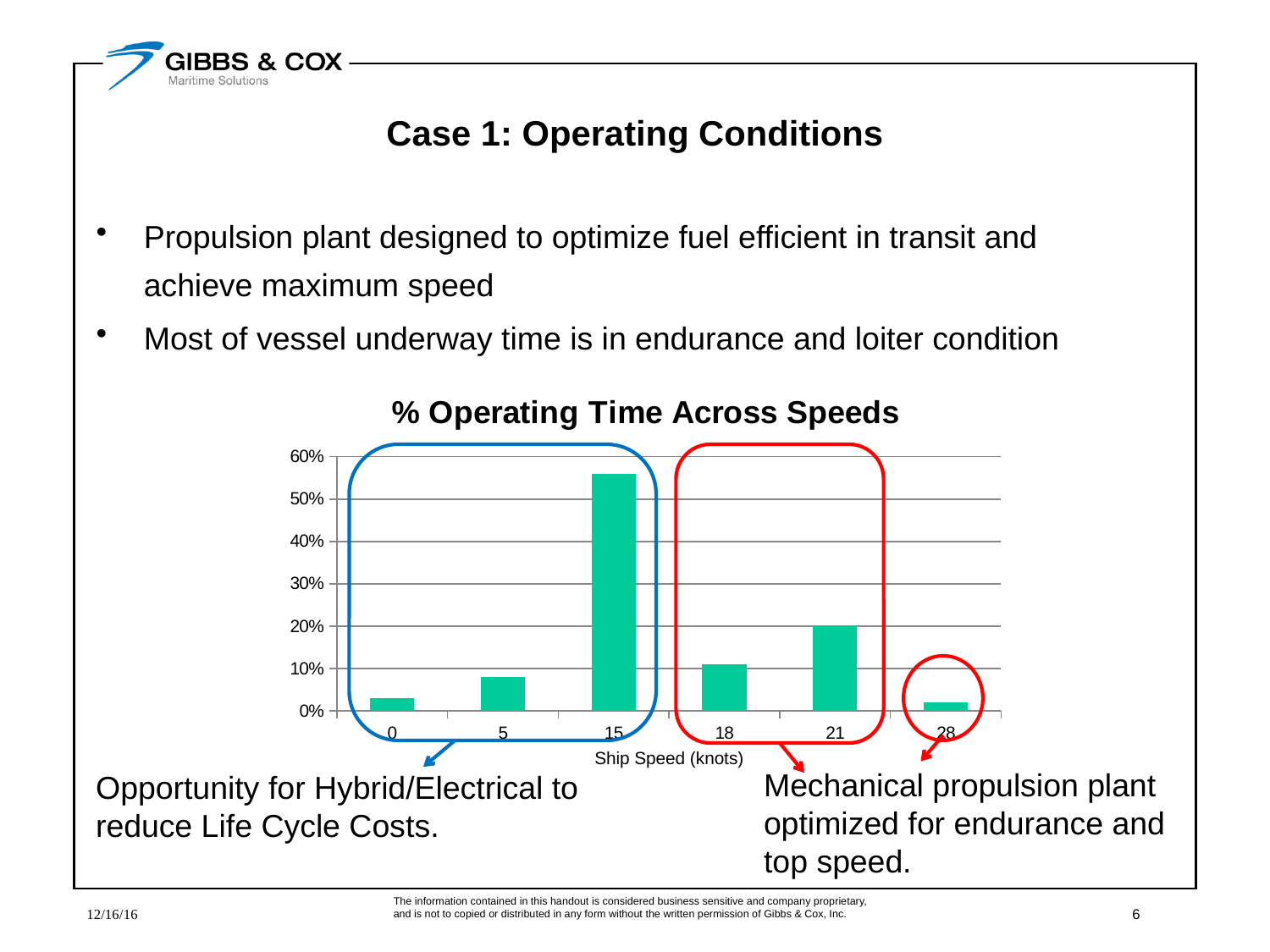
Which has a larger percentage of operating time, a ship speed of 5 knots or 0 knots? 5 Which ship speed has the lowest percentage of operating time? 28 Is the value for a ship speed of 18 knots greater or less than 20%? less What kind of chart is shown on the slide? bar chart Which ship speed has the highest percentage of operating time? 15 How many ship speed categories are plotted in the chart? 6 What is the label of the x axis of the chart? Ship Speed (knots) Which has a larger percentage of operating time, a ship speed of 21 knots or 18 knots? 21 Is the value for a ship speed of 15 knots greater or less than 50%? greater Do the values rise steadily from 0 knots to 28 knots along the x axis? No What is the title of the chart? % Operating Time Across Speeds Is the value for a ship speed of 5 knots greater or less than 10%? less